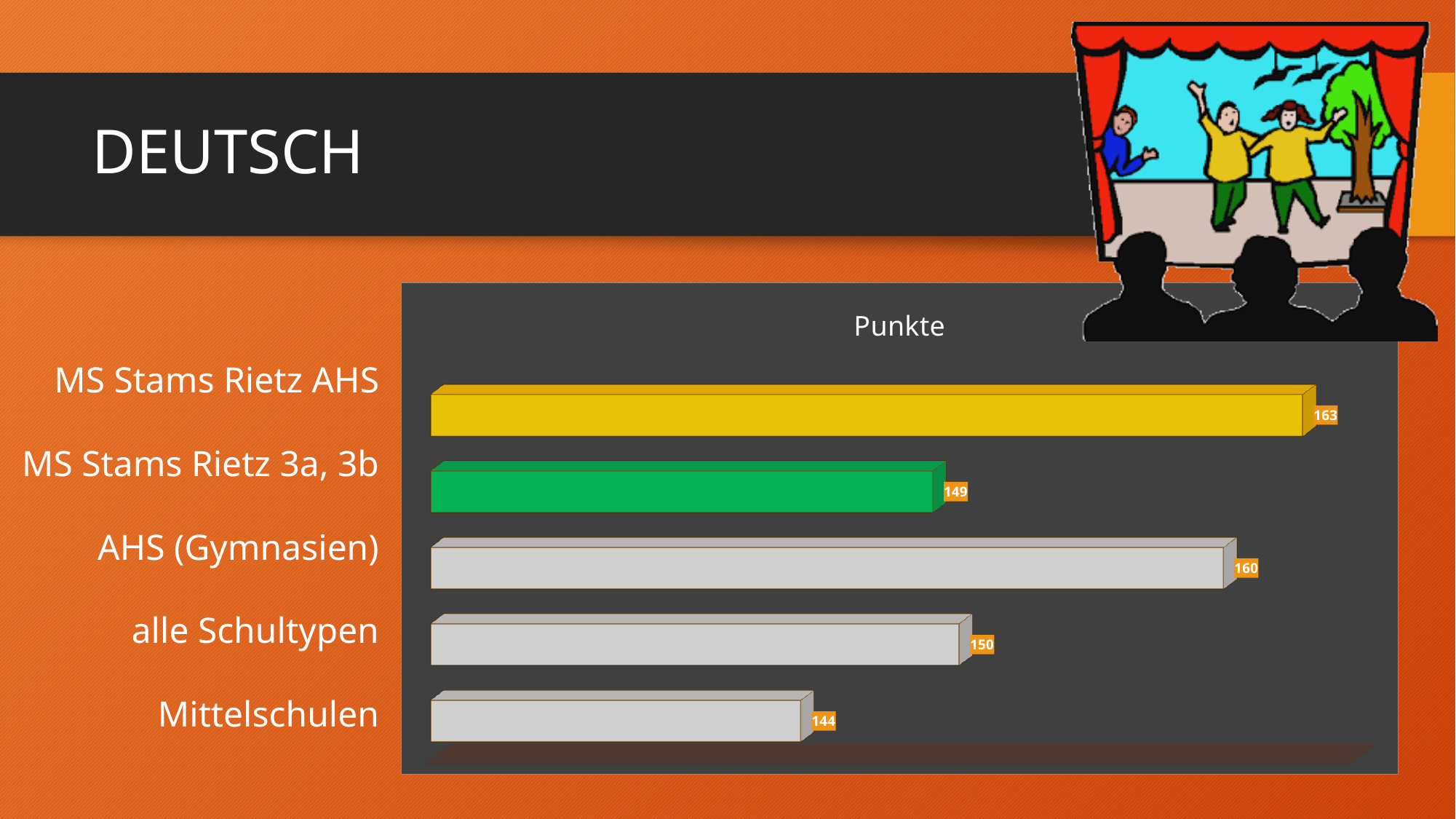
What is the value for MS Stams Rietz AHS? 163 What is the value for AHS (Gymnasien)? 160 What is the difference between the values for MS Stams Rietz AHS and Mittelschulen? 19 Which is larger, the value for MS Stams Rietz 3a, 3b or the value for Mittelschulen? MS Stams Rietz 3a, 3b What is the difference between the values for AHS (Gymnasien) and MS Stams Rietz 3a, 3b? 11 What is the value for MS Stams Rietz 3a, 3b? 149 What kind of chart is shown on the slide? bar chart Which category has the lowest value? Mittelschulen What is the value for Mittelschulen? 144 What is the value for alle Schultypen? 150 How many categories are shown in the chart? 5 Which category has the highest value? MS Stams Rietz AHS